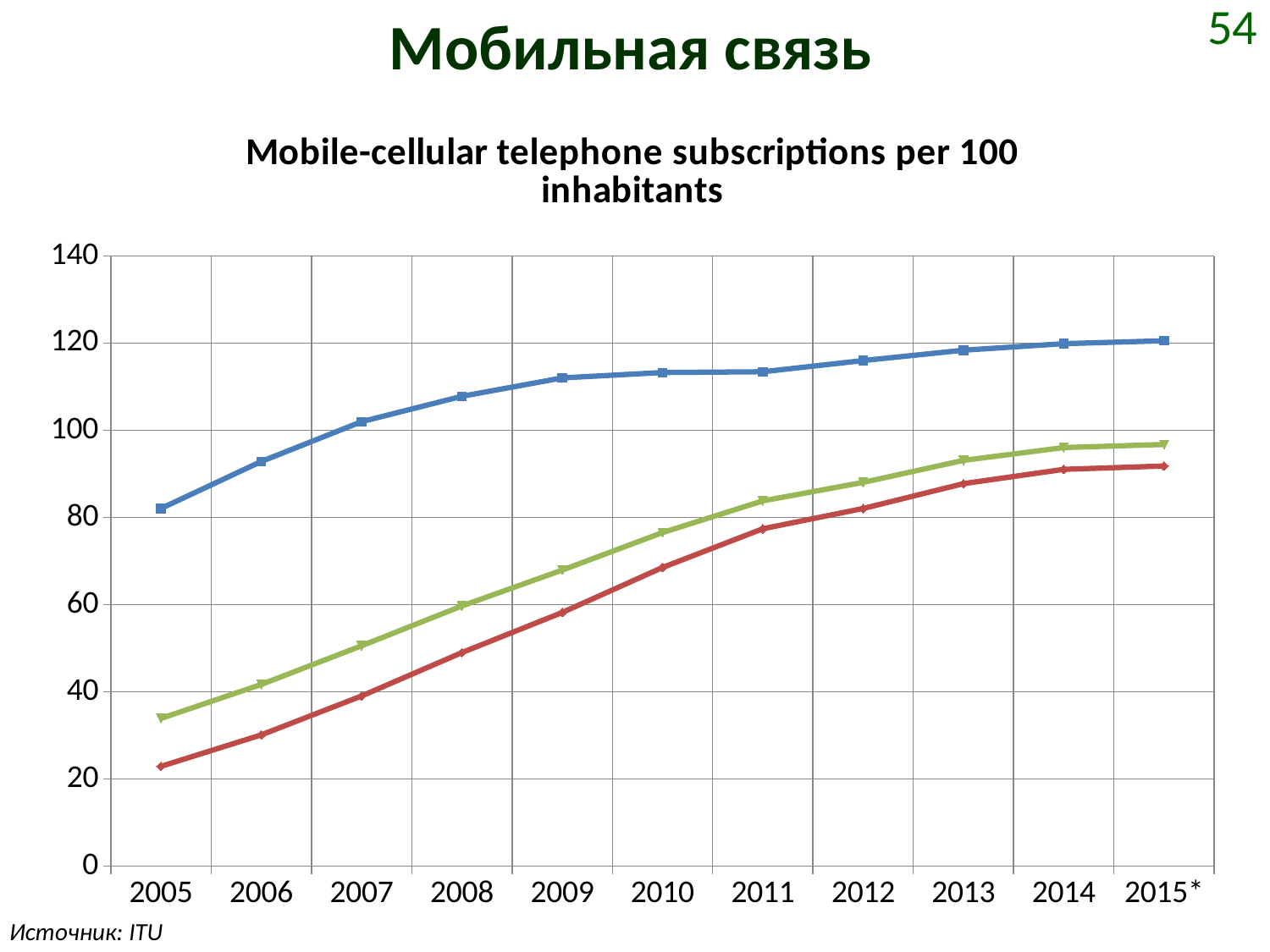
Is the value of the green line in 2009 greater or less than 60? greater Is the value of the red line in 2005 greater or less than 40? less How many lines are plotted on the chart? 3 Which line is highest in 2015*: the blue, green or red line? blue Do the values of the red line rise or fall from 2005 to 2015*? rise What is the title of the chart? Mobile-cellular telephone subscriptions per 100 inhabitants Is the value of the green line in 2015* greater or less than 100? less Which line is lowest in 2005: the blue, green or red line? red What kind of chart is shown on the slide? line chart In 2010, which is larger: the value of the blue line or the value of the red line? blue line How many years are shown on the x axis of the chart? 11